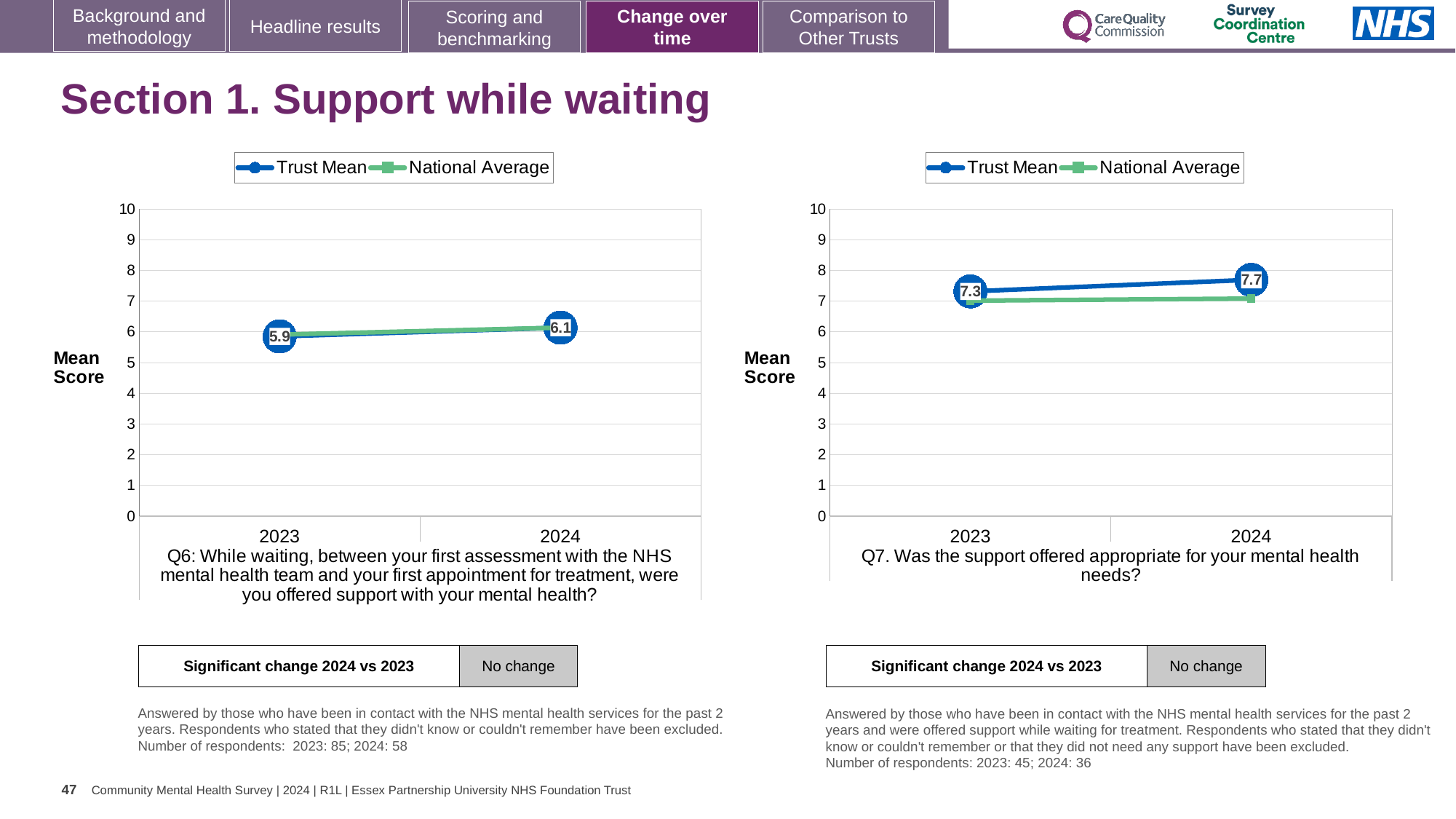
In the right chart (Q7), what is the Trust Mean for 2024? 7.7 In the right chart (Q7), what is the Trust Mean for 2023? 7.3 In the left chart (Q6), is the Trust Mean for 2024 greater or less than 7? less In the right chart (Q7), by how much did the Trust Mean change from 2023 to 2024? 0.4 In the left chart (Q6), what is the Trust Mean for 2023? 5.9 What kind of chart is the right chart (Q7)? line chart In the left chart (Q6), by how much did the Trust Mean change from 2023 to 2024? 0.2 In the right chart (Q7), is the National Average for 2024 greater or less than 8? less How many years are plotted on the x axis of the left chart (Q6)? 2 In the right chart (Q7), does the Trust Mean rise or fall from 2023 to 2024? rise How many series does the legend of the left chart (Q6) list? 2 In the left chart (Q6), what is the Trust Mean for 2024? 6.1